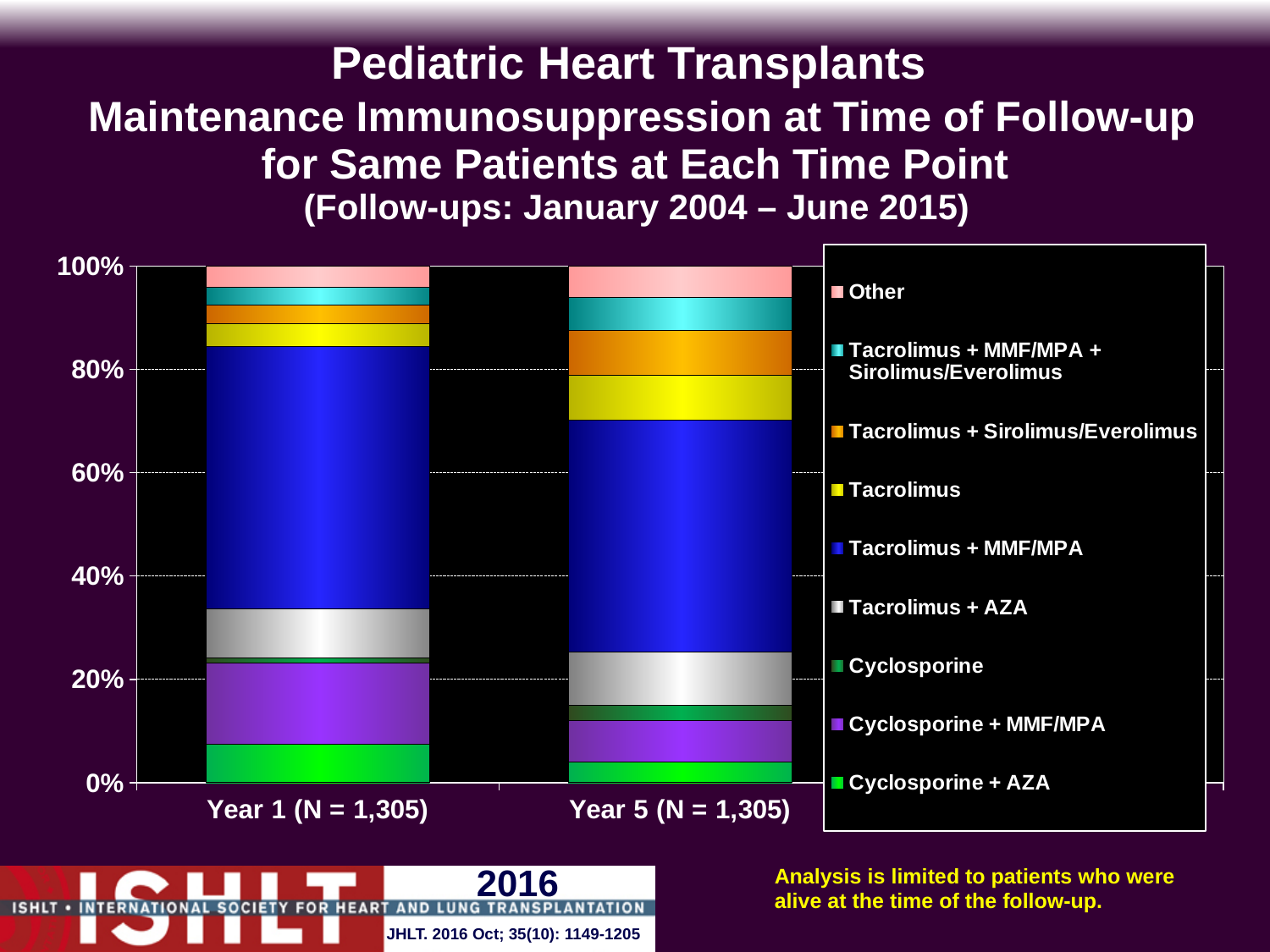
Is the Cyclosporine + AZA share in Year 1 greater or less than 20%? less How many series does the legend list? 9 Is the Tacrolimus + Sirolimus/Everolimus segment larger in Year 1 or Year 5? Year 5 What kind of chart is shown on the slide? stacked bar chart What is the total of each stacked bar on the chart? 100% Is the Cyclosporine + MMF/MPA segment larger in Year 1 or Year 5? Year 1 Which immunosuppression regimen makes up the largest segment of the Year 1 bar? Tacrolimus + MMF/MPA Which immunosuppression regimen makes up the largest segment of the Year 5 bar? Tacrolimus + MMF/MPA Which regimen makes up the smallest segment of the Year 1 bar? Cyclosporine How many bars (time points) are plotted on the chart? 2 Which legend entry is listed at the top of the legend? Other What is the N shown for the Year 1 bar? 1,305